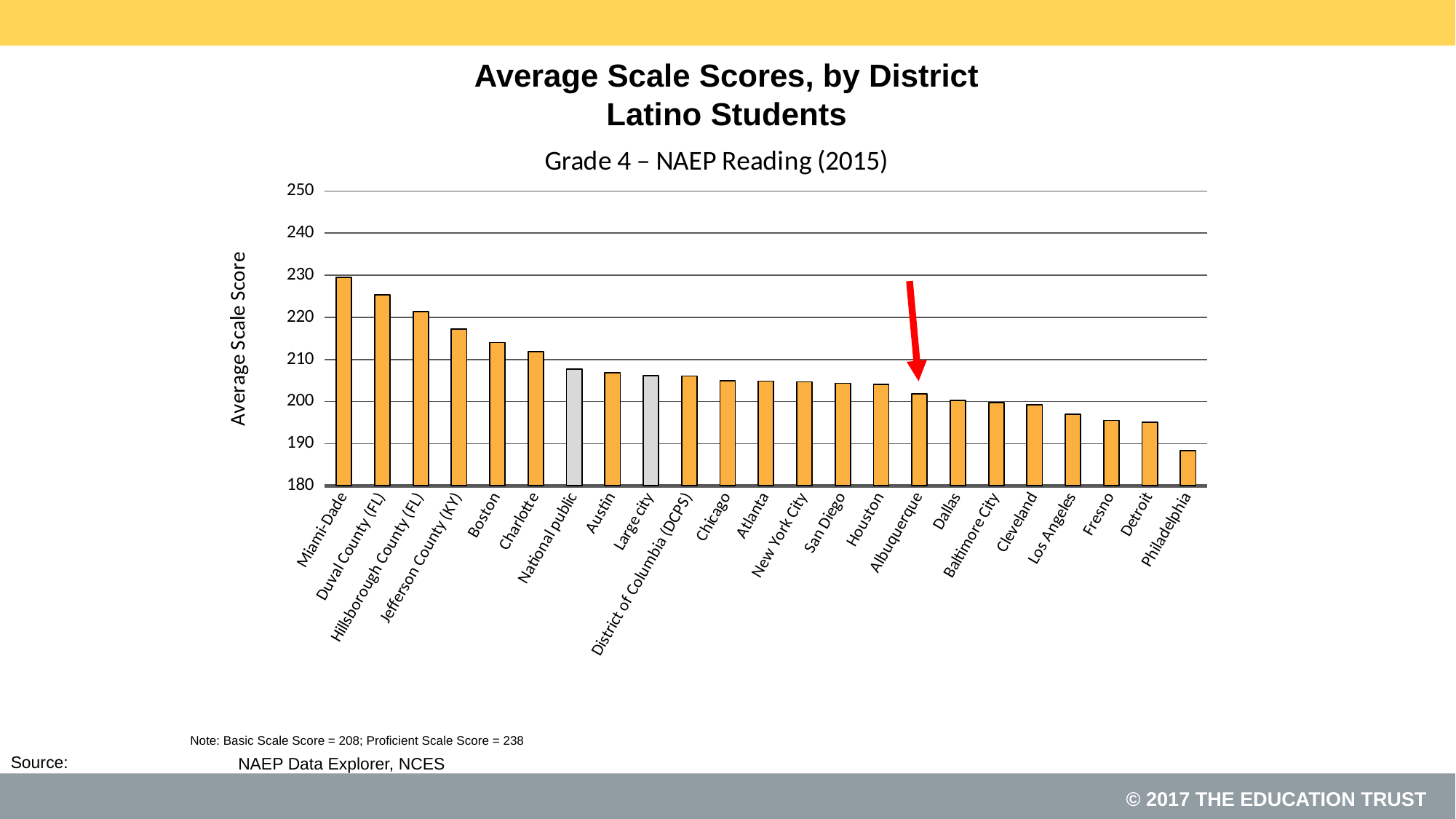
What kind of chart is shown on the slide? Bar chart Which district has the lowest average scale score? Philadelphia How many bars are plotted in the chart? 23 Which has a higher average scale score, Charlotte or Fresno? Charlotte Is the value for Miami-Dade greater or less than 220? greater Is the value for Detroit greater or less than 200? less Do the bars rise or fall moving from left to right along the x axis? Fall Is the value for Philadelphia greater or less than 200? less Which district has the highest average scale score? Miami-Dade What is the label on the vertical axis? Average Scale Score Which district does the red arrow point to? Albuquerque